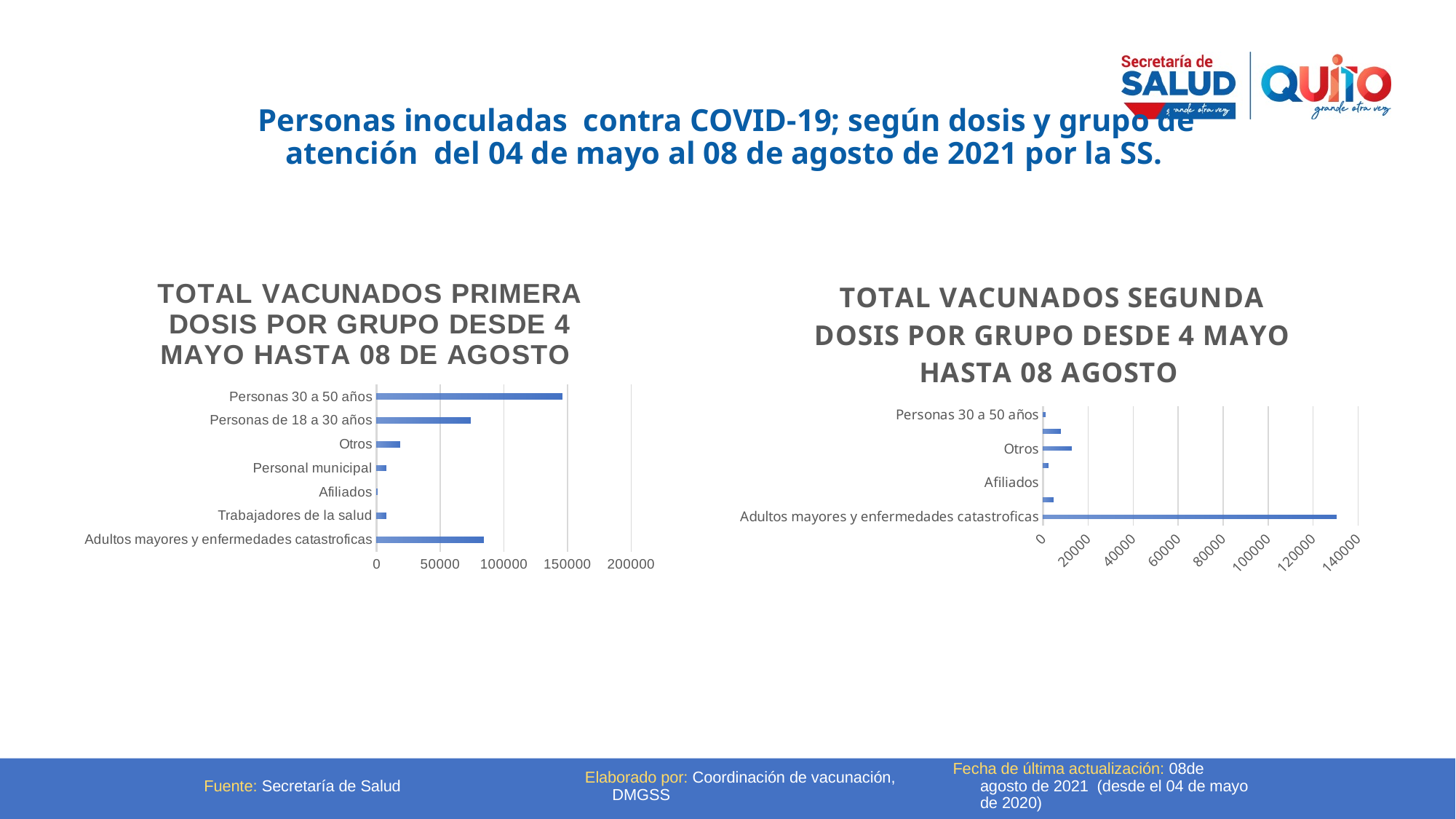
In the 'TOTAL VACUNADOS SEGUNDA DOSIS POR GRUPO' chart on the right, which group has the highest value? Adultos mayores y enfermedades catastroficas In the 'TOTAL VACUNADOS PRIMERA DOSIS POR GRUPO' chart on the left, is the value for Personas 30 a 50 años greater or less than 100000? greater What kind of chart is the 'TOTAL VACUNADOS PRIMERA DOSIS POR GRUPO' chart on the left? Bar chart In the 'TOTAL VACUNADOS SEGUNDA DOSIS POR GRUPO' chart on the right, is the value for Otros greater or less than 20000? less In the 'TOTAL VACUNADOS PRIMERA DOSIS POR GRUPO' chart on the left, which group has the highest value? Personas 30 a 50 años In the 'TOTAL VACUNADOS PRIMERA DOSIS POR GRUPO' chart on the left, which is larger: Otros or Personal municipal? Otros In the 'TOTAL VACUNADOS PRIMERA DOSIS POR GRUPO' chart on the left, is the value for Otros greater or less than 50000? less What is the highest tick value on the horizontal axis of the 'TOTAL VACUNADOS SEGUNDA DOSIS POR GRUPO' chart on the right? 140000 How many categories are shown in the 'TOTAL VACUNADOS PRIMERA DOSIS POR GRUPO' chart on the left? 7 In the 'TOTAL VACUNADOS PRIMERA DOSIS POR GRUPO' chart on the left, which group has the lowest value? Afiliados In the 'TOTAL VACUNADOS PRIMERA DOSIS POR GRUPO' chart on the left, which is larger: Personas de 18 a 30 años or Adultos mayores y enfermedades catastroficas? Adultos mayores y enfermedades catastroficas